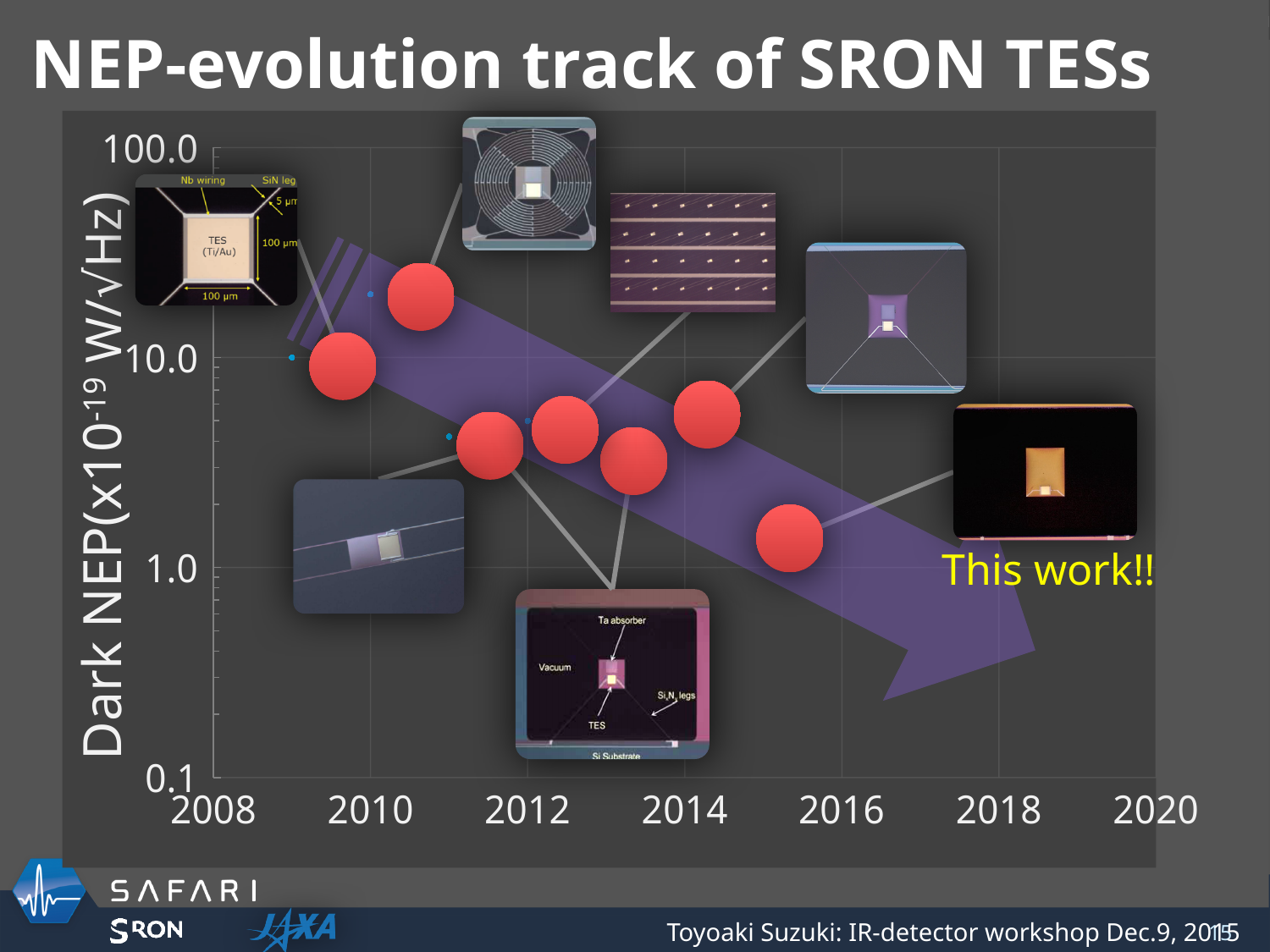
What is the title of the slide's chart? NEP-evolution track of SRON TESs Is the Dark NEP value of the data point plotted around 2013 greater or less than 10.0? less What kind of chart is shown on the slide? scatter chart Which has the larger Dark NEP value: the data point plotted around 2010-2011 or the data point plotted around 2015? the point around 2010-2011 What is the first year shown on the x axis? 2008 Is the Dark NEP value of the data point plotted around 2015 greater or less than 10.0? less Is the Dark NEP value of the data point plotted around 2015 greater or less than 1.0? greater What is the label of the y axis? Dark NEP(x10^-19 W/√Hz) How many red data points are plotted on the chart? 7 Around which year is the data point with the lowest Dark NEP value plotted? 2015 Do the plotted Dark NEP values generally rise or fall as the year increases? fall